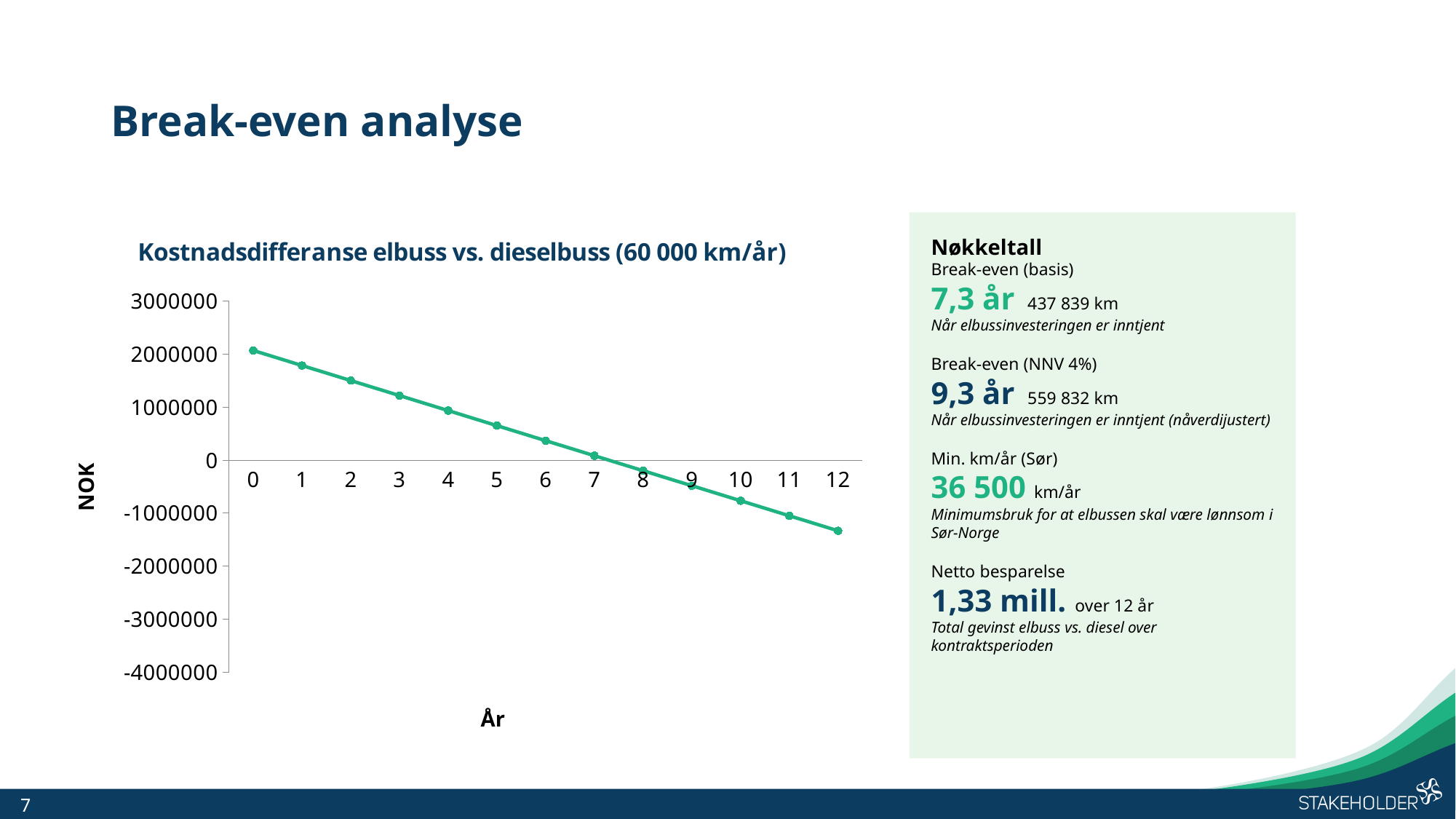
Which has the larger value, year 2 or year 9? year 2 Is the value for year 8 greater or less than 0? less Is the value for year 1 greater or less than 2000000? less What is the label on the vertical axis of the chart? NOK Is the value for year 12 greater or less than -1000000? less At which year is the plotted value lowest? 12 At which year is the plotted value highest? 0 What is the title of the chart? Kostnadsdifferanse elbuss vs. dieselbuss (60 000 km/år) What kind of chart is shown on the slide? line chart Do the values rise or fall as the year increases along the x axis? fall How many data points are plotted on the line? 13